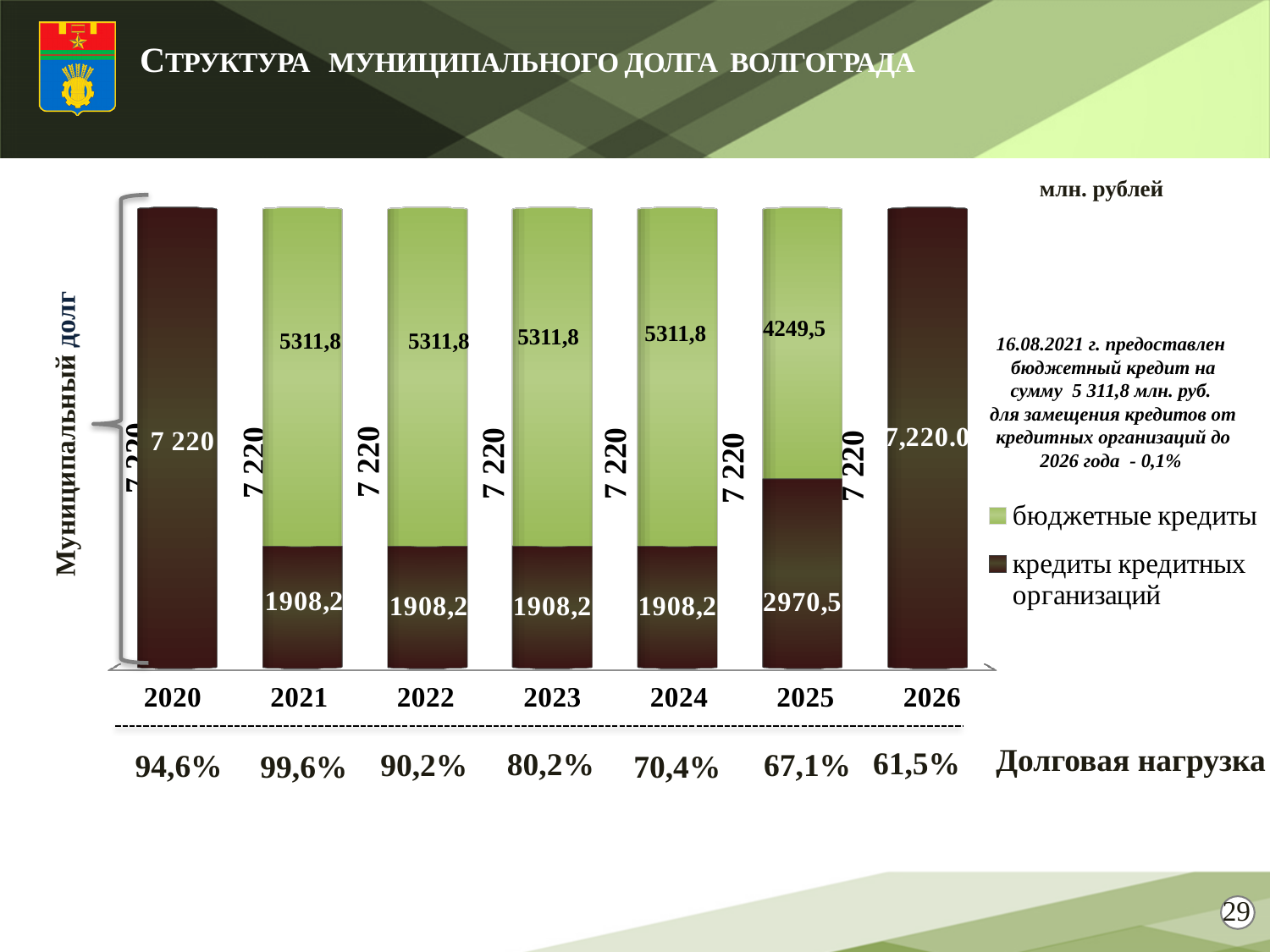
What is the value of бюджетные кредиты for 2021? 5311,8 What is the value of бюджетные кредиты for 2025? 4249,5 How many years are shown on the x axis of the chart? 7 What is the value of кредиты кредитных организаций for 2023? 1908,2 What is the value of кредиты кредитных организаций for 2025? 2970,5 How many series does the legend list? 2 What is the difference between бюджетные кредиты in 2024 and in 2025? 1062,3 What is the Долговая нагрузка value shown for 2026? 61,5% What is the total municipal debt shown for 2024? 7 220 Which year has the highest value of бюджетные кредиты? 2021, 2022, 2023 and 2024 (5311,8 each) What type of chart is shown on the slide? stacked bar chart Which is larger in 2025: бюджетные кредиты or кредиты кредитных организаций? бюджетные кредиты